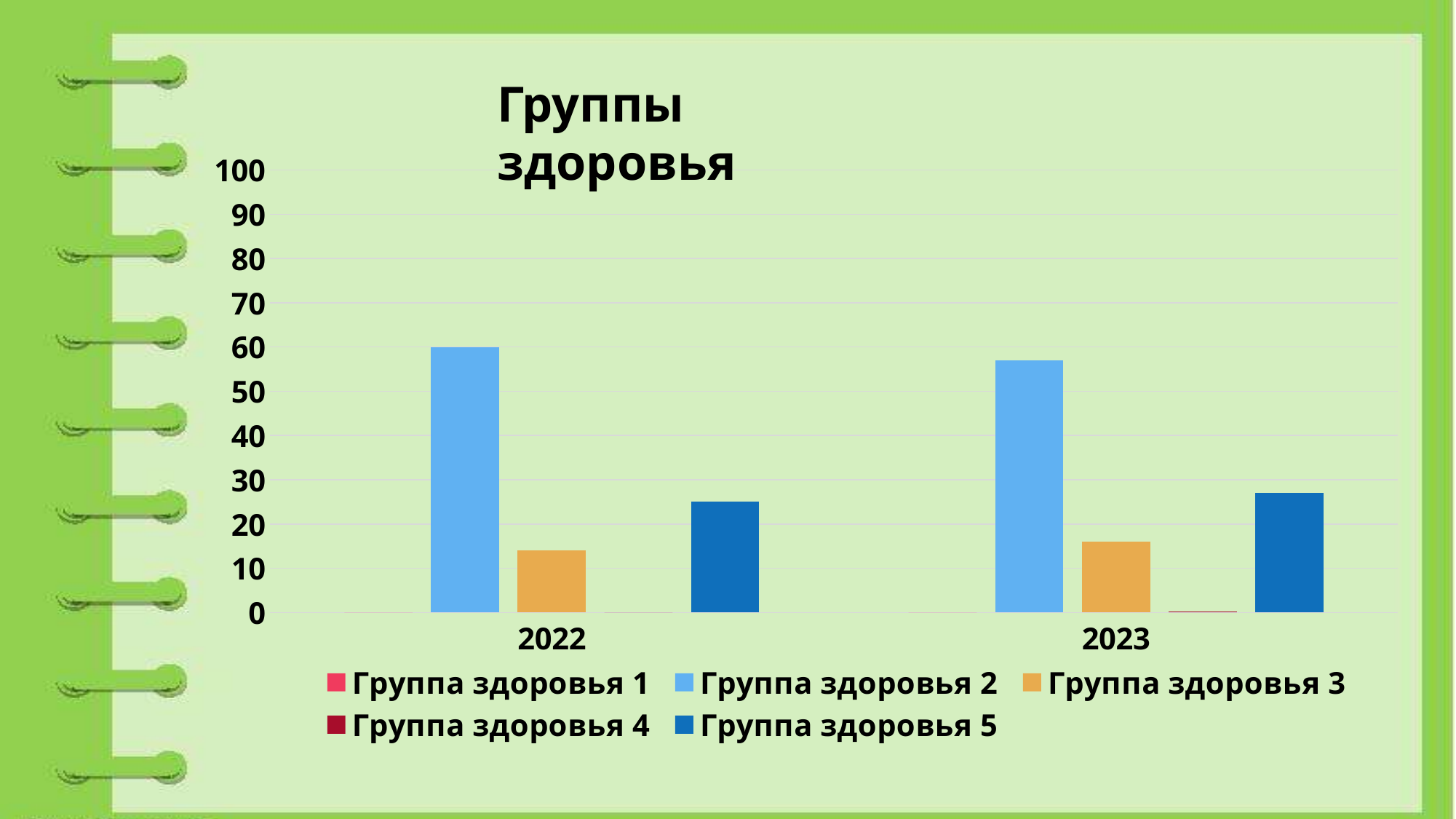
Does the value for Группа здоровья 2 rise or fall from 2022 to 2023? fall How many categories (years) are shown on the x axis? 2 Is the value for Группа здоровья 2 in 2023 greater or less than 50? greater What kind of chart is shown on the slide? bar chart What is the value for Группа здоровья 2 in 2022? 60 In 2022, which is larger: Группа здоровья 3 or Группа здоровья 5? Группа здоровья 5 Which series has the highest value in 2023? Группа здоровья 2 How many series does the legend list? 5 Is the value for Группа здоровья 3 in 2022 greater or less than 20? less What is the title of the chart? Группы здоровья Is the value for Группа здоровья 5 in 2023 greater or less than 30? less Which series has the highest value in 2022? Группа здоровья 2